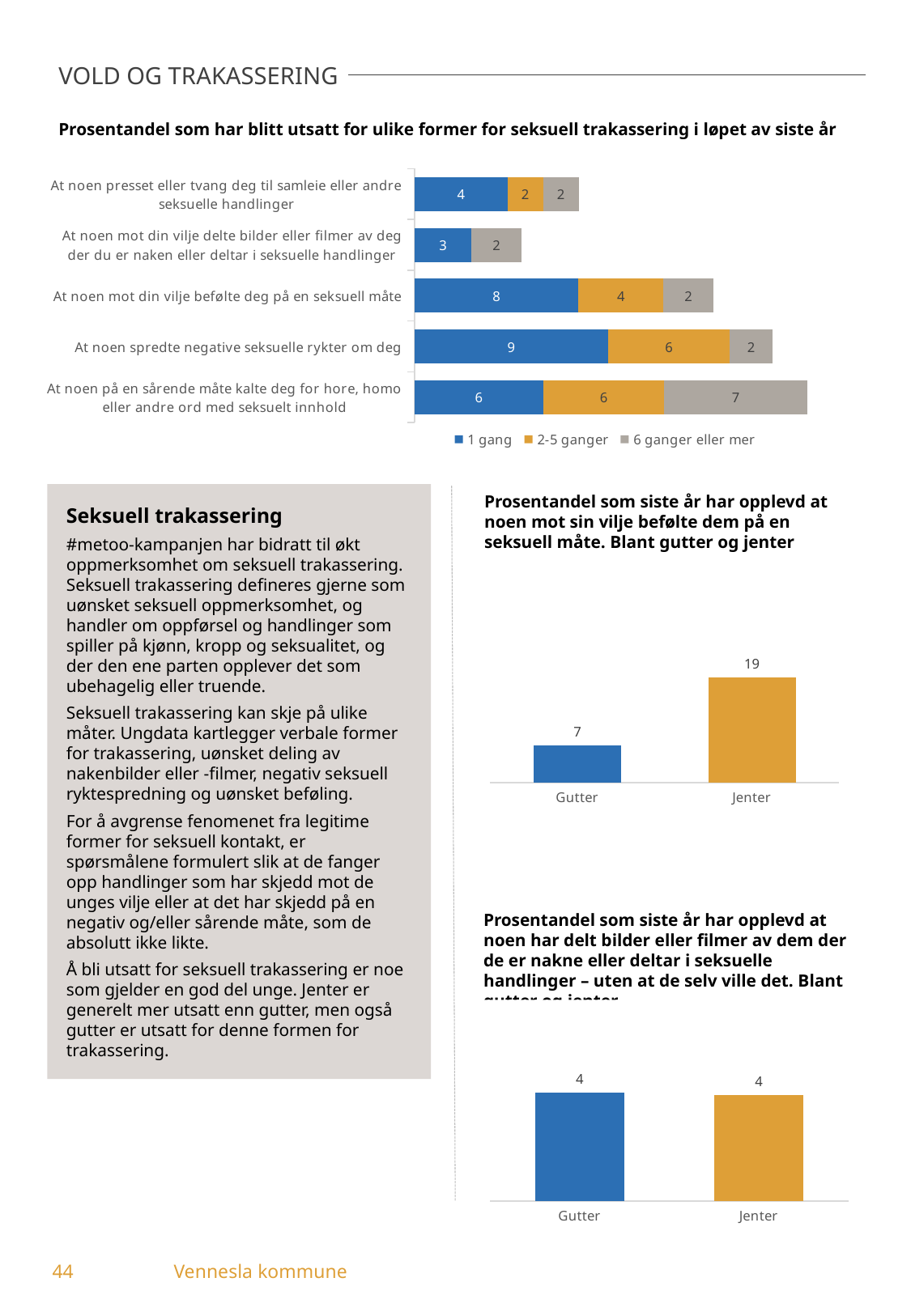
In the top chart 'Prosentandel som har blitt utsatt for ulike former for seksuell trakassering i løpet av siste år', what is the '1 gang' value for 'At noen spredte negative seksuelle rykter om deg'? 9 In the chart 'Prosentandel som siste år har opplevd at noen mot sin vilje befølte dem på en seksuell måte', what is the difference between Jenter and Gutter? 12 In the top chart, what is the total of the stacked bar for 'At noen spredte negative seksuelle rykter om deg'? 17 In the chart 'Prosentandel som siste år har opplevd at noen mot sin vilje befølte dem på en seksuell måte', what is the value for Jenter? 19 In the top chart, what is the '6 ganger eller mer' value for 'At noen på en sårende måte kalte deg for hore, homo eller andre ord med seksuelt innhold'? 7 In the top chart, which category has the highest '1 gang' value? At noen spredte negative seksuelle rykter om deg In the bottom right chart about delte bilder eller filmer, which is larger, Gutter or Jenter? They are equal (both 4) How many series does the legend of the top chart list? 3 In the top chart, what is the '2-5 ganger' value for 'At noen mot din vilje befølte deg på en seksuell måte'? 4 In the top chart, what is the total of the stacked bar for 'At noen på en sårende måte kalte deg for hore, homo eller andre ord med seksuelt innhold'? 19 How many categories are shown in the top chart? 5 What kind of chart is the top chart on the slide? Stacked bar chart